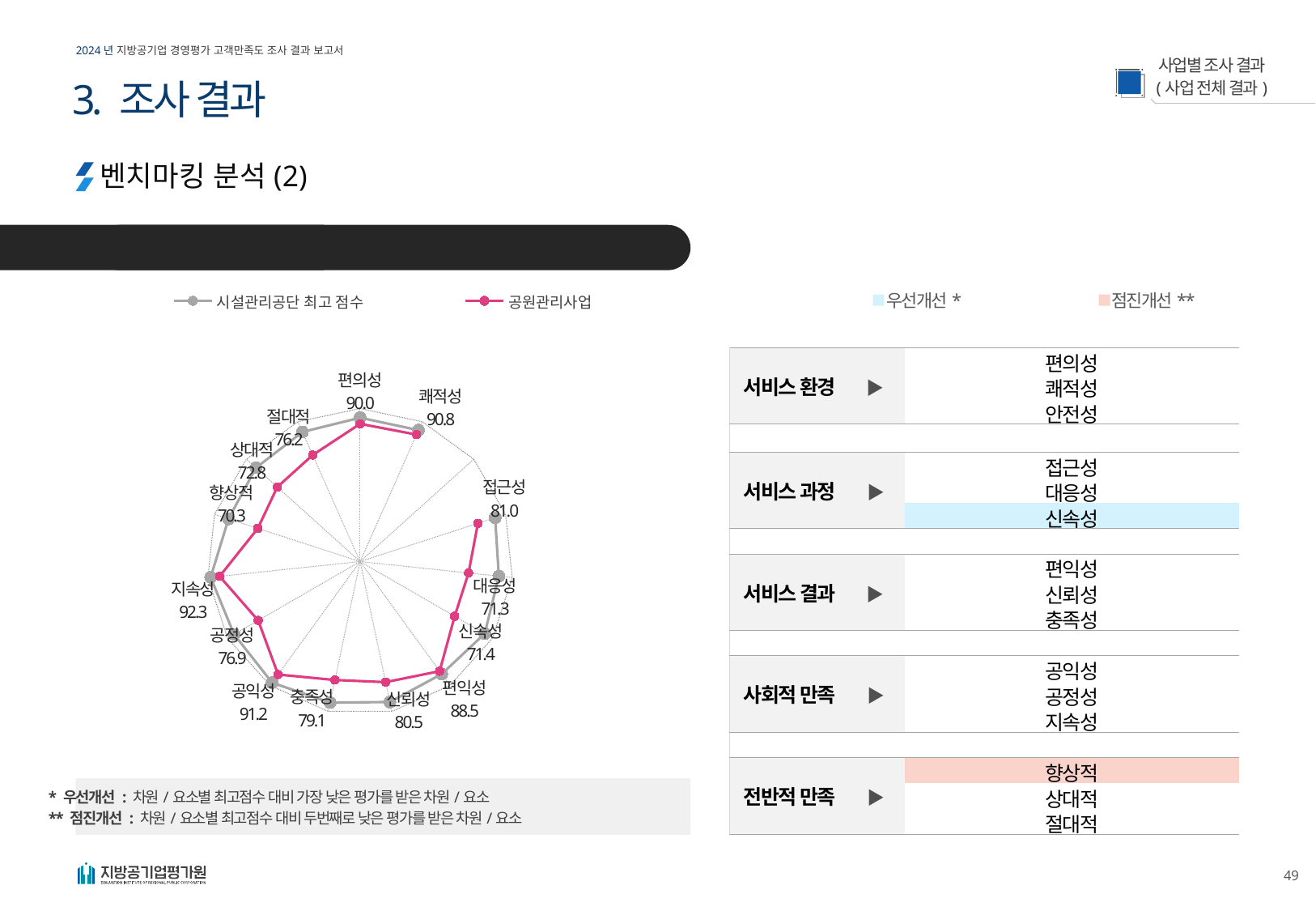
Which has a larger labeled value, 편익성 or 신뢰성? 편익성 What value is labeled for 편의성 on the radar chart? 90.0 What are the two series names shown in the chart legend? 시설관리공단 최고 점수, 공원관리사업 What type of chart is shown on the slide? Radar chart What value is labeled for 공익성 on the radar chart? 91.2 Which category has the highest labeled value on the radar chart? 지속성 How many series does the chart legend list? 2 What value is labeled for 지속성 on the radar chart? 92.3 What is the difference between the labeled values for 지속성 and 향상적? 22.0 What value is labeled for 신속성 on the radar chart? 71.4 Which category has the lowest labeled value on the radar chart? 향상적 How many categories (axes) does the radar chart have? 15